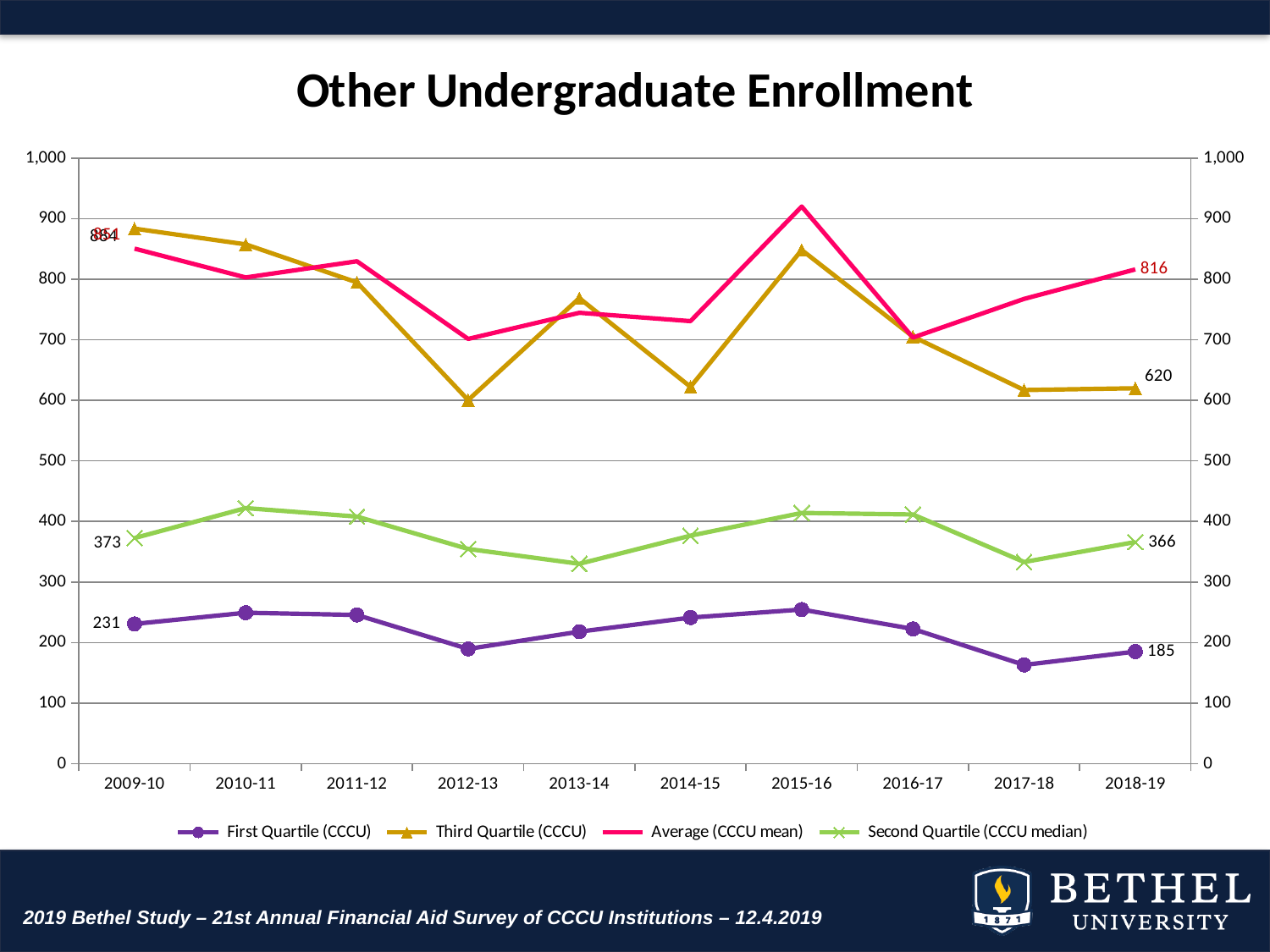
What is the value of First Quartile (CCCU) in 2018-19? 185 What is the value of Average (CCCU mean) in 2018-19? 816 What is the value of Third Quartile (CCCU) in 2018-19? 620 What is the value of Second Quartile (CCCU median) in 2018-19? 366 Is the Third Quartile (CCCU) value for 2012-13 greater or less than 700? less What is the value of First Quartile (CCCU) in 2009-10? 231 What kind of chart is shown on the slide? line chart Which year has the lowest First Quartile (CCCU) value? 2017-18 What is the difference between the Average (CCCU mean) and Third Quartile (CCCU) values in 2018-19? 196 How many series does the legend list? 4 What is the difference between the Second Quartile (CCCU median) value in 2009-10 and in 2018-19? 7 Which year has the highest Average (CCCU mean) value? 2015-16